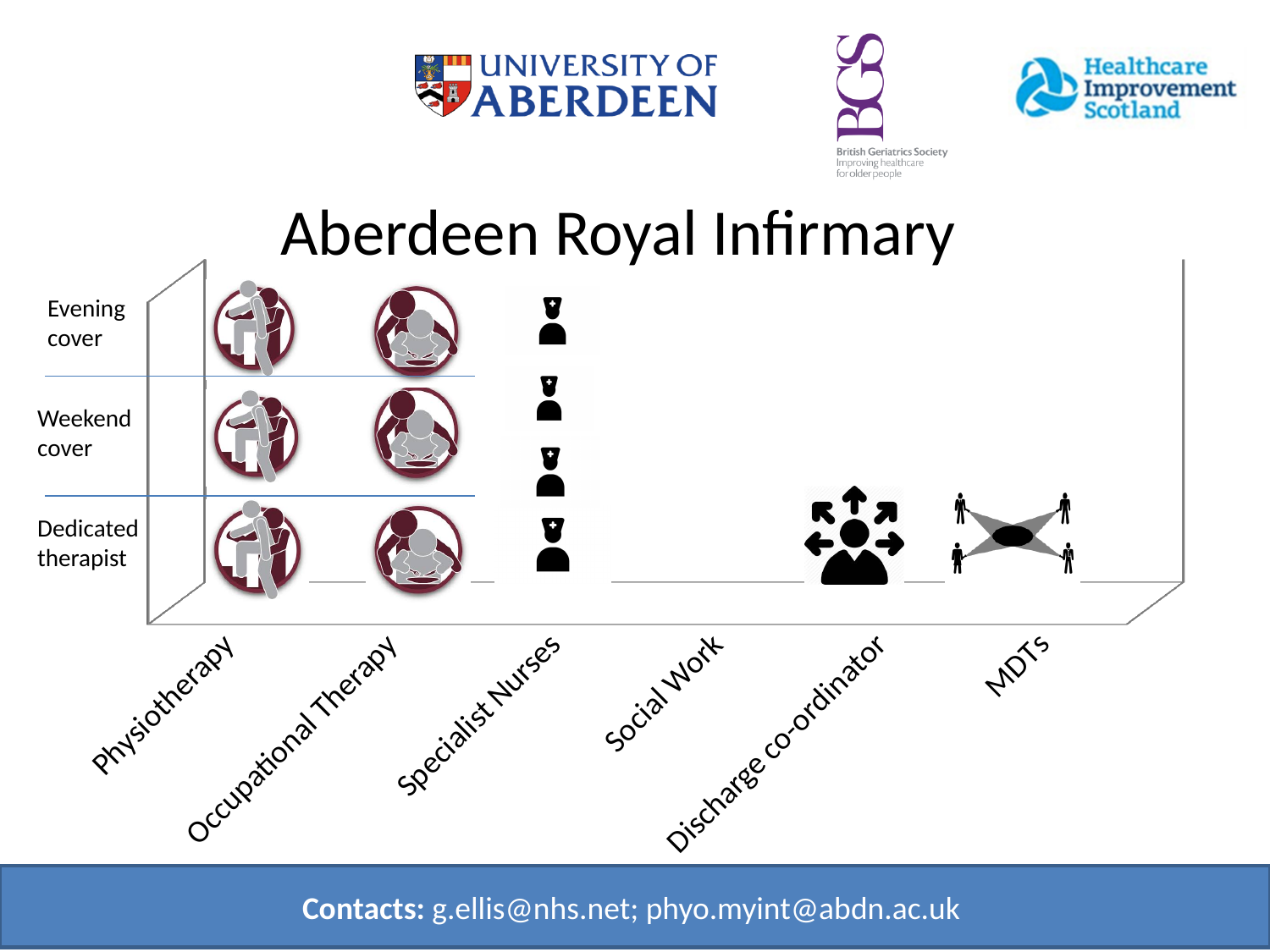
Which category has no icons plotted at all? Social Work What is the highest level of cover reached by MDTs? Dedicated therapist How many icons are stacked for Physiotherapy? 3 How many service categories are shown along the x axis? 6 Which category has the most icons stacked? Specialist Nurses Which has more icons stacked, Occupational Therapy or MDTs? Occupational Therapy How many levels of cover are labelled on the y axis? 3 Does Physiotherapy reach the Evening cover level? Yes What is the label of the lowest level on the y axis? Dedicated therapist What is the title of the chart? Aberdeen Royal Infirmary How many icons are stacked for Specialist Nurses? 4 What is the highest level of cover reached by Discharge co-ordinator? Dedicated therapist